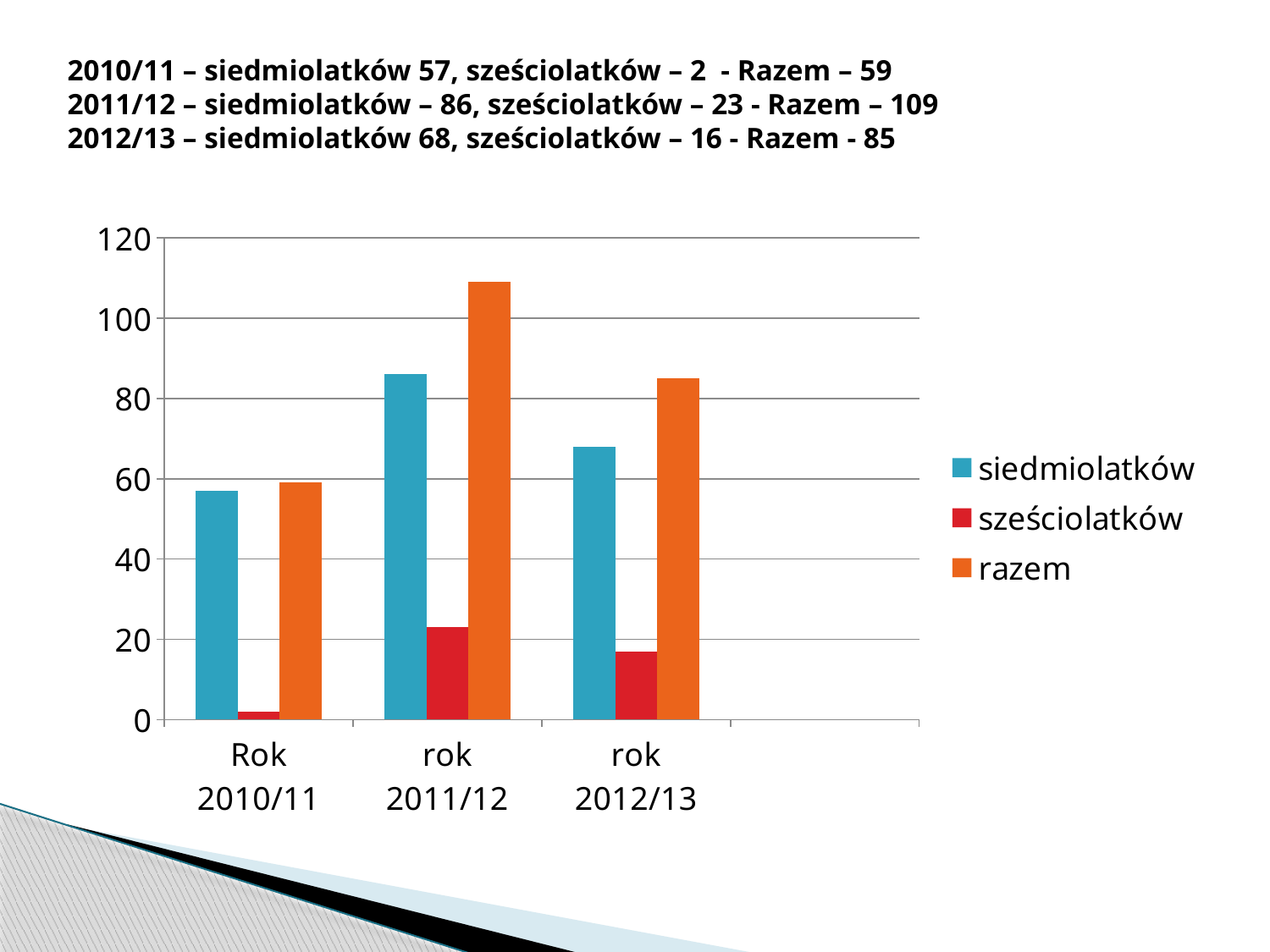
Which is larger: siedmiolatków for rok 2012/13 or siedmiolatków for Rok 2010/11? rok 2012/13 What kind of chart is shown on the slide? bar chart What is the value of siedmiolatków for rok 2011/12? 86 Which legend entry is shown in red? sześciolatków How many year categories are shown on the x axis? 3 How many series does the legend list? 3 Which year has the highest razem value? rok 2011/12 Which year has the lowest sześciolatków value? Rok 2010/11 What is the razem value for Rok 2010/11? 59 What is the difference between the razem values for rok 2011/12 and rok 2012/13? 24 Is the razem value for rok 2011/12 greater or less than 100? greater